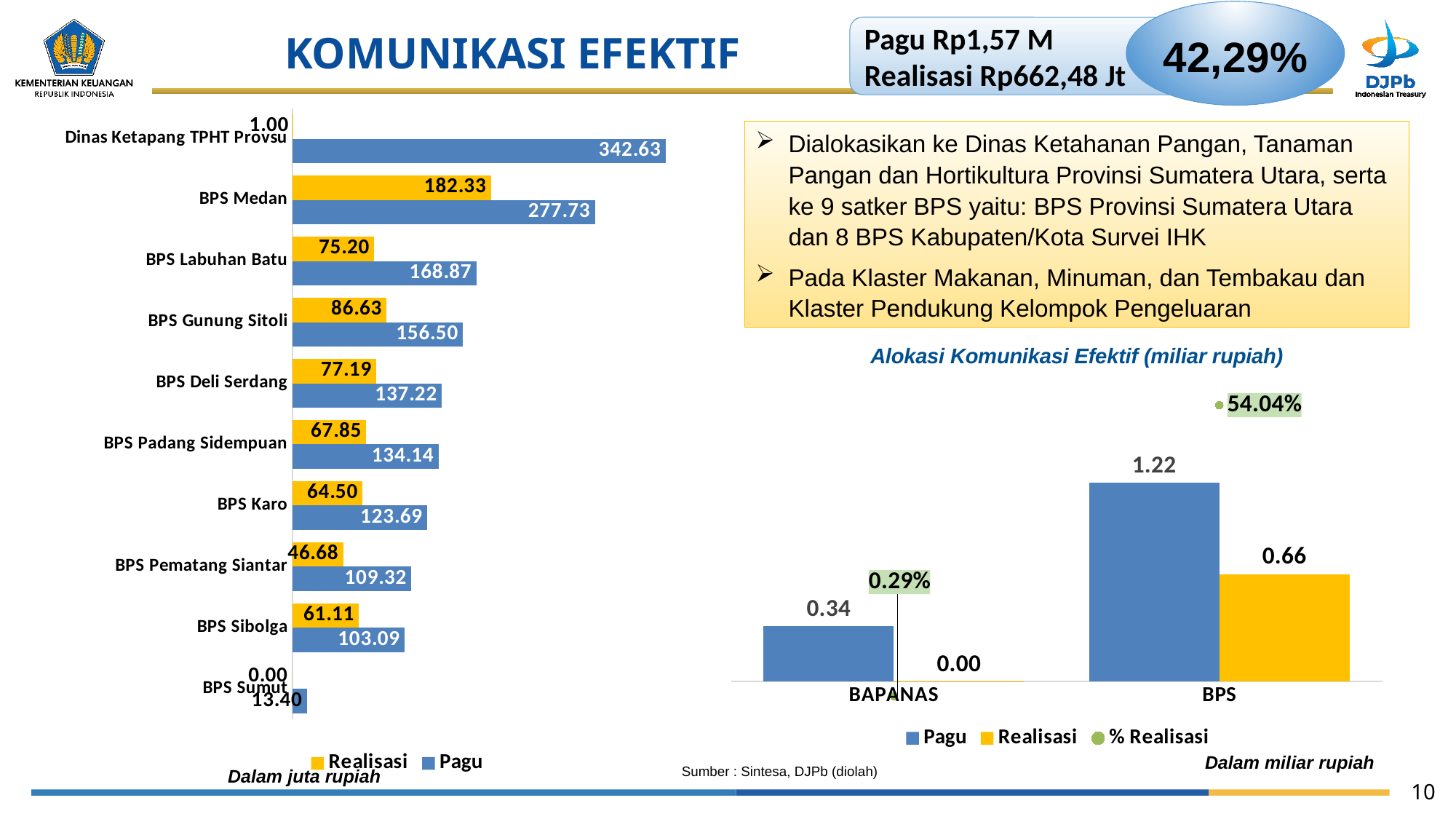
What type of chart is the left chart on the slide? Bar chart In the left bar chart, what is the Realisasi value for BPS Gunung Sitoli? 86.63 In the left bar chart, what is the difference between the Pagu and Realisasi values for BPS Labuhan Batu? 93.67 In the chart titled 'Alokasi Komunikasi Efektif (miliar rupiah)', what is the % Realisasi value for BAPANAS? 0.29% How many categories are shown in the left bar chart? 10 In the chart titled 'Alokasi Komunikasi Efektif (miliar rupiah)', what is the Pagu value for BPS? 1.22 In the left bar chart, which category has the lowest Pagu value? BPS Sumut In the chart titled 'Alokasi Komunikasi Efektif (miliar rupiah)', what is the difference between the Pagu and Realisasi values for BPS? 0.56 In the left bar chart, which category has the highest Pagu value? Dinas Ketapang TPHT Provsu How many series does the legend of the chart titled 'Alokasi Komunikasi Efektif (miliar rupiah)' list? 3 In the left bar chart, which is larger: the Realisasi value for BPS Sibolga or the Realisasi value for BPS Pematang Siantar? BPS Sibolga In the left bar chart, what is the Pagu value for BPS Medan? 277.73